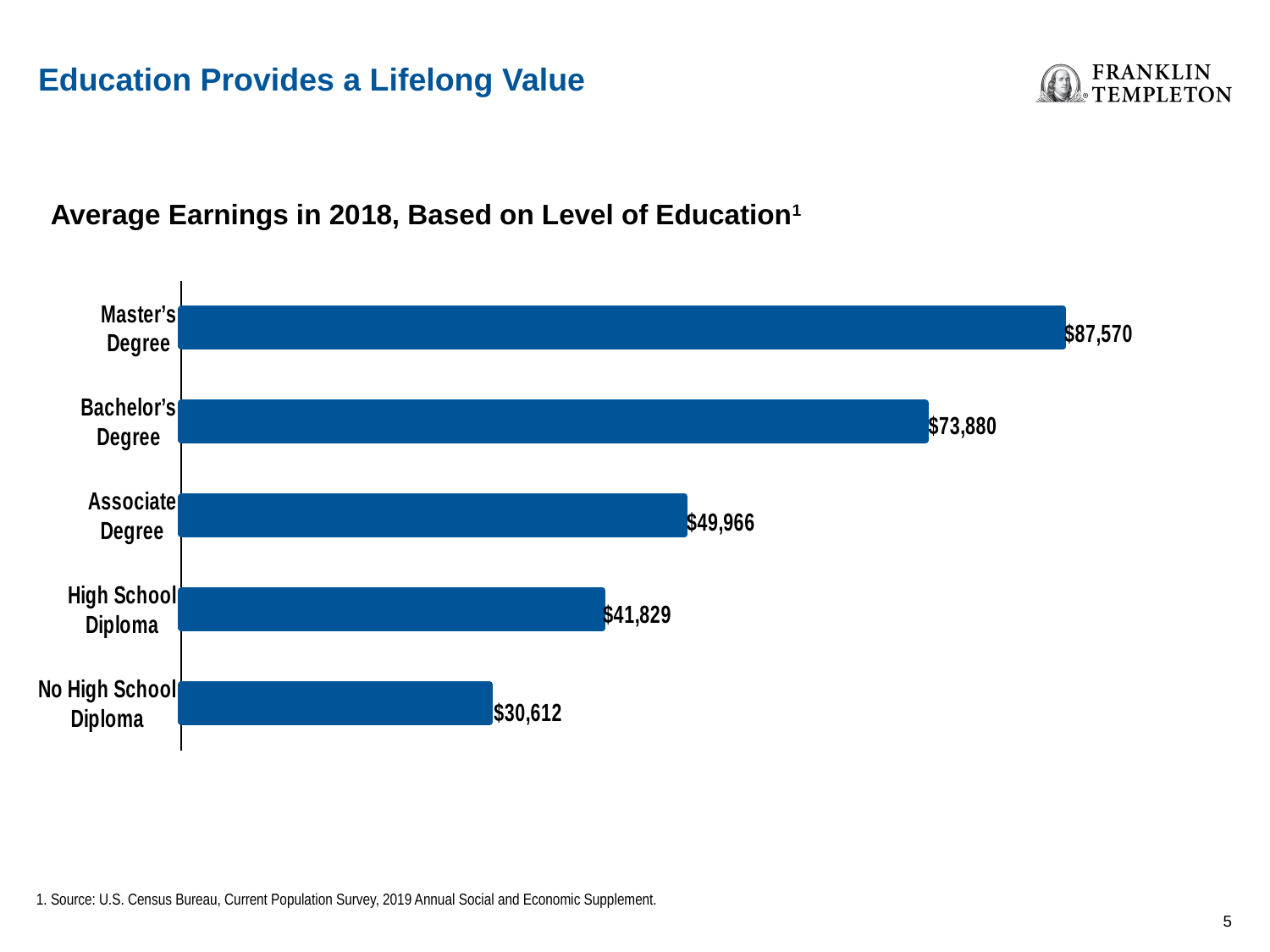
What kind of chart is shown on the slide? Bar chart Which has higher average earnings, an Associate Degree or a High School Diploma? Associate Degree Which level of education has the lowest average earnings? No High School Diploma What are the average earnings for a High School Diploma? $41,829 What are the average earnings for a Bachelor's Degree? $73,880 What are the average earnings for No High School Diploma? $30,612 What is the difference in average earnings between a High School Diploma and No High School Diploma? $11,217 What are the average earnings for a Master's Degree? $87,570 What are the average earnings for an Associate Degree? $49,966 How many levels of education are shown in the chart? 5 What is the difference in average earnings between a Master's Degree and a Bachelor's Degree? $13,690 Which level of education has the highest average earnings? Master's Degree